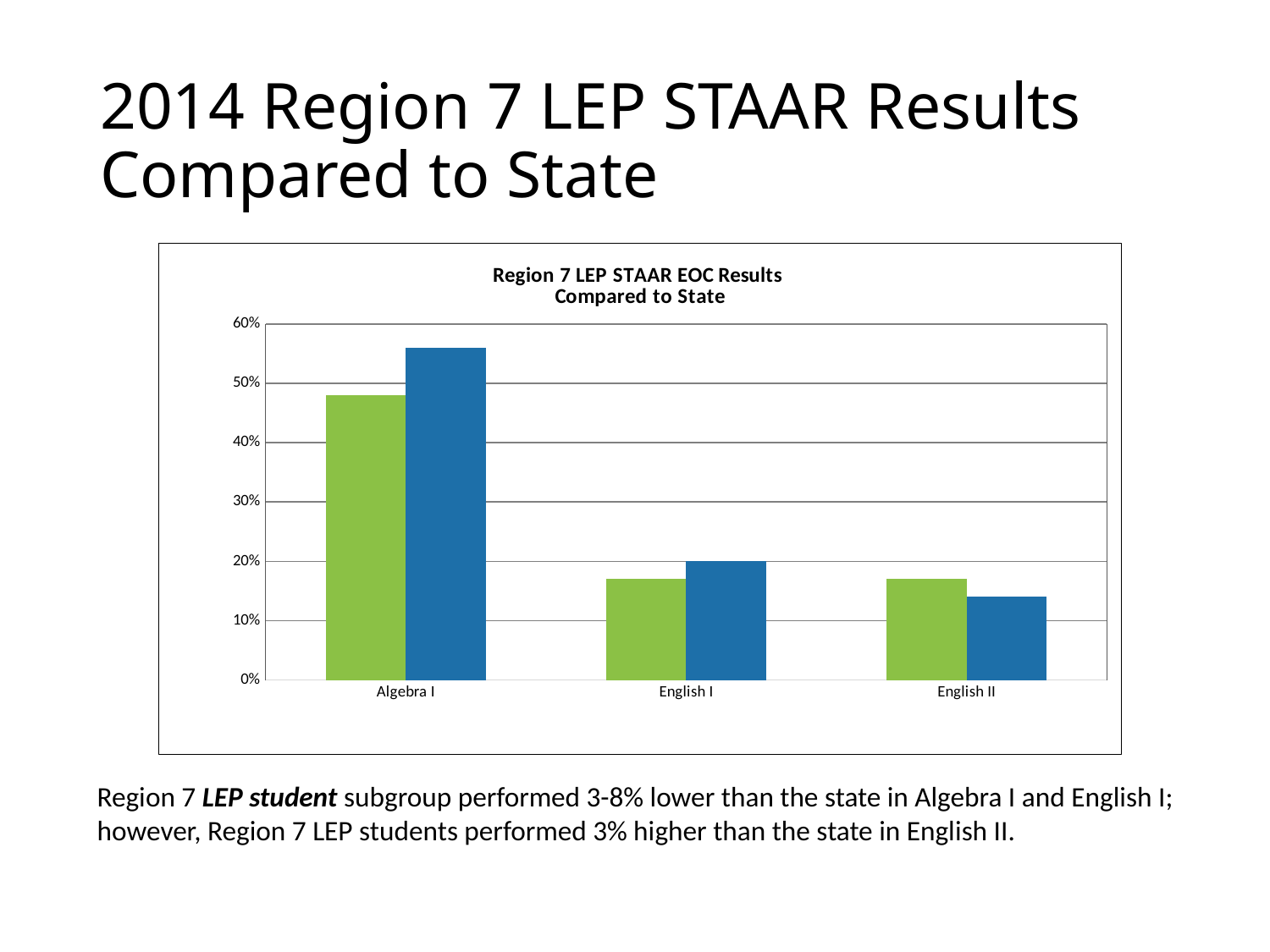
For Algebra I, is the green bar or the blue bar taller? blue Is the value of the green bar for English I greater or less than 20%? less Is the value of the blue bar for English II greater or less than 20%? less What is the title of the chart? Region 7 LEP STAAR EOC Results Compared to State Which category has the tallest bar in the chart? Algebra I Which category has the shortest bar in the chart? English II How many categories are shown on the x axis of the chart? 3 Is the value of the blue bar for Algebra I greater or less than 50%? greater For English II, is the green bar or the blue bar taller? green What kind of chart is shown on the slide? bar chart How many bars are shown for each category in the chart? 2